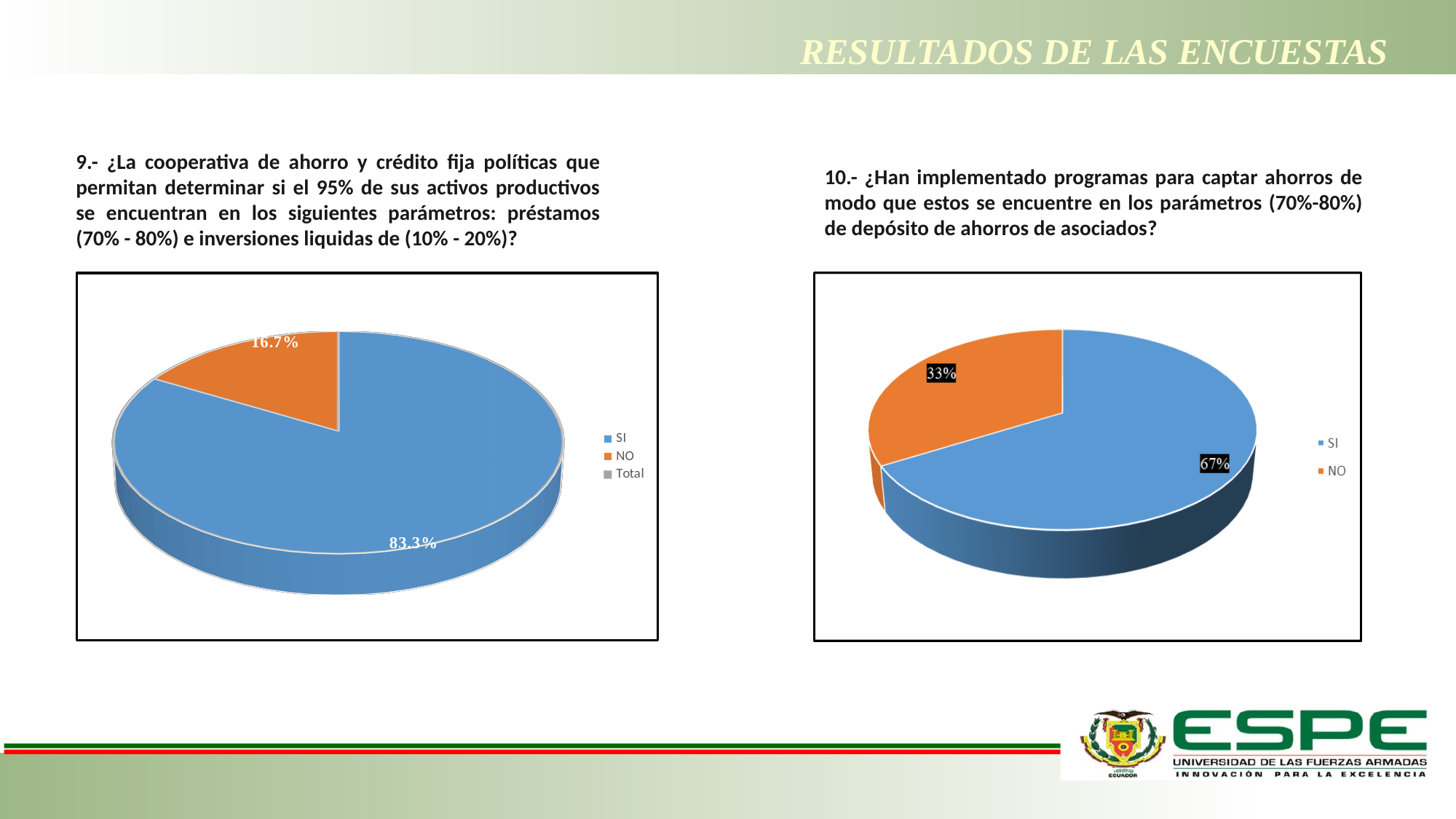
In the left pie chart (question 9), what percentage is shown for SI? 83.3% In the right pie chart (question 10), what percentage is shown for NO? 33% In the right pie chart (question 10), what colour is the SI slice? Blue In the right pie chart (question 10), what percentage is shown for SI? 67% In the right pie chart (question 10), which is larger, SI or NO? SI How many entries does the legend of the left pie chart (question 9) list? 3 In the left pie chart (question 9), which category has the largest slice? SI What kind of chart is used on the left side of the slide (question 9)? Pie chart In the left pie chart (question 9), what is the difference between the SI and NO percentages? 66.6% In the left pie chart (question 9), what percentage is shown for NO? 16.7% In the right pie chart (question 10), which category has the smallest slice? NO In the right pie chart (question 10), what is the difference between the SI and NO percentages? 34%